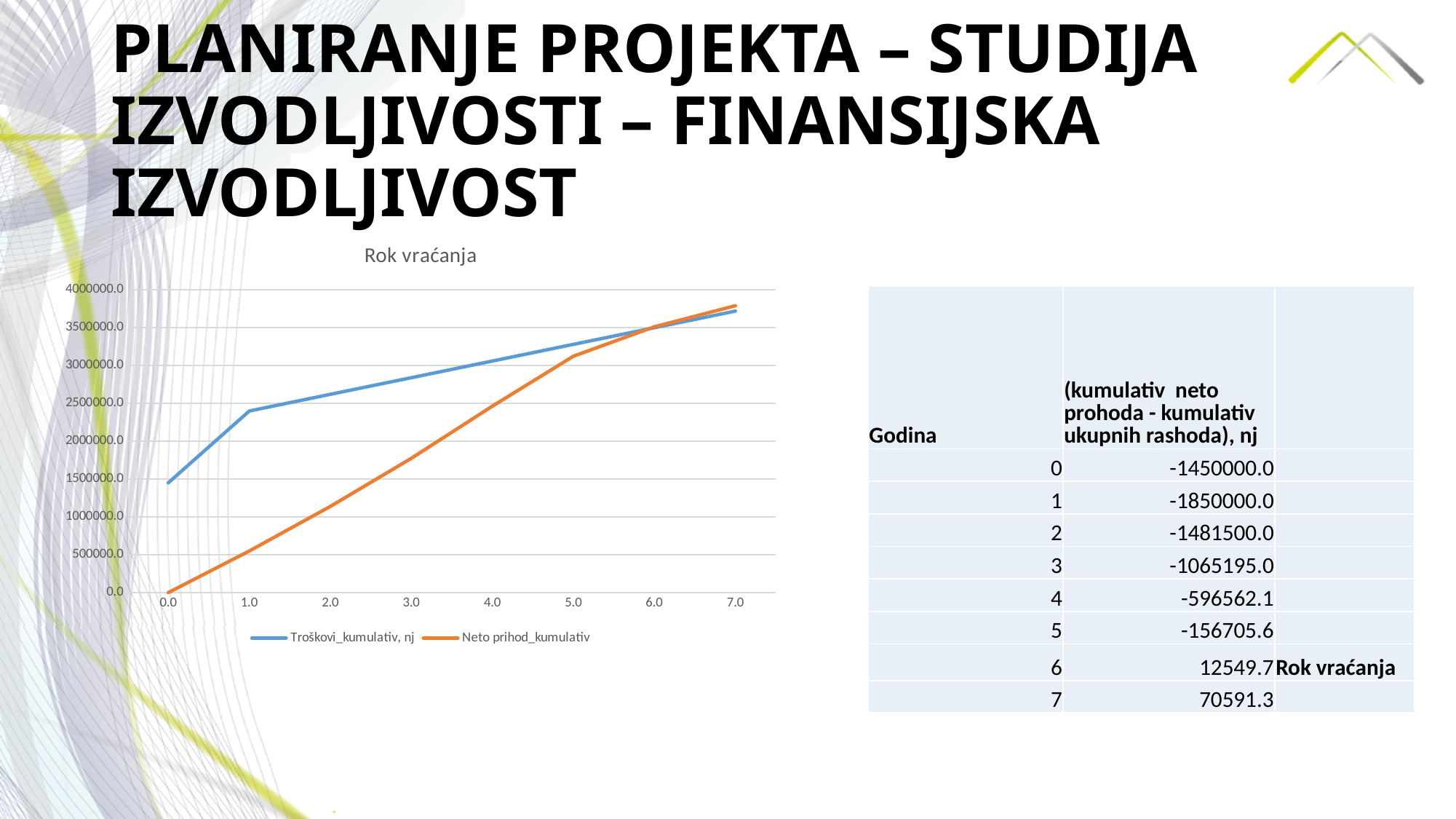
How many series does the chart's legend list? 2 How many x-axis points (years) are plotted for each series in the chart? 8 Is the value of Troškovi_kumulativ, nj at x = 0.0 greater or less than 1000000.0? greater Does the Neto prihod_kumulativ series rise or fall as x increases from 0.0 to 7.0? rise What kind of chart is shown on the slide? line chart What is the title of the chart? Rok vraćanja Is the value of Neto prihod_kumulativ at x = 5.0 greater or less than 2500000.0? greater At x = 3.0, which series has the larger value, Troškovi_kumulativ, nj or Neto prihod_kumulativ? Troškovi_kumulativ, nj Which series is drawn in orange in the chart? Neto prihod_kumulativ What is the value of Neto prihod_kumulativ at x = 0.0? 0.0 Is the value of Troškovi_kumulativ, nj at x = 1.0 greater or less than 2000000.0? greater